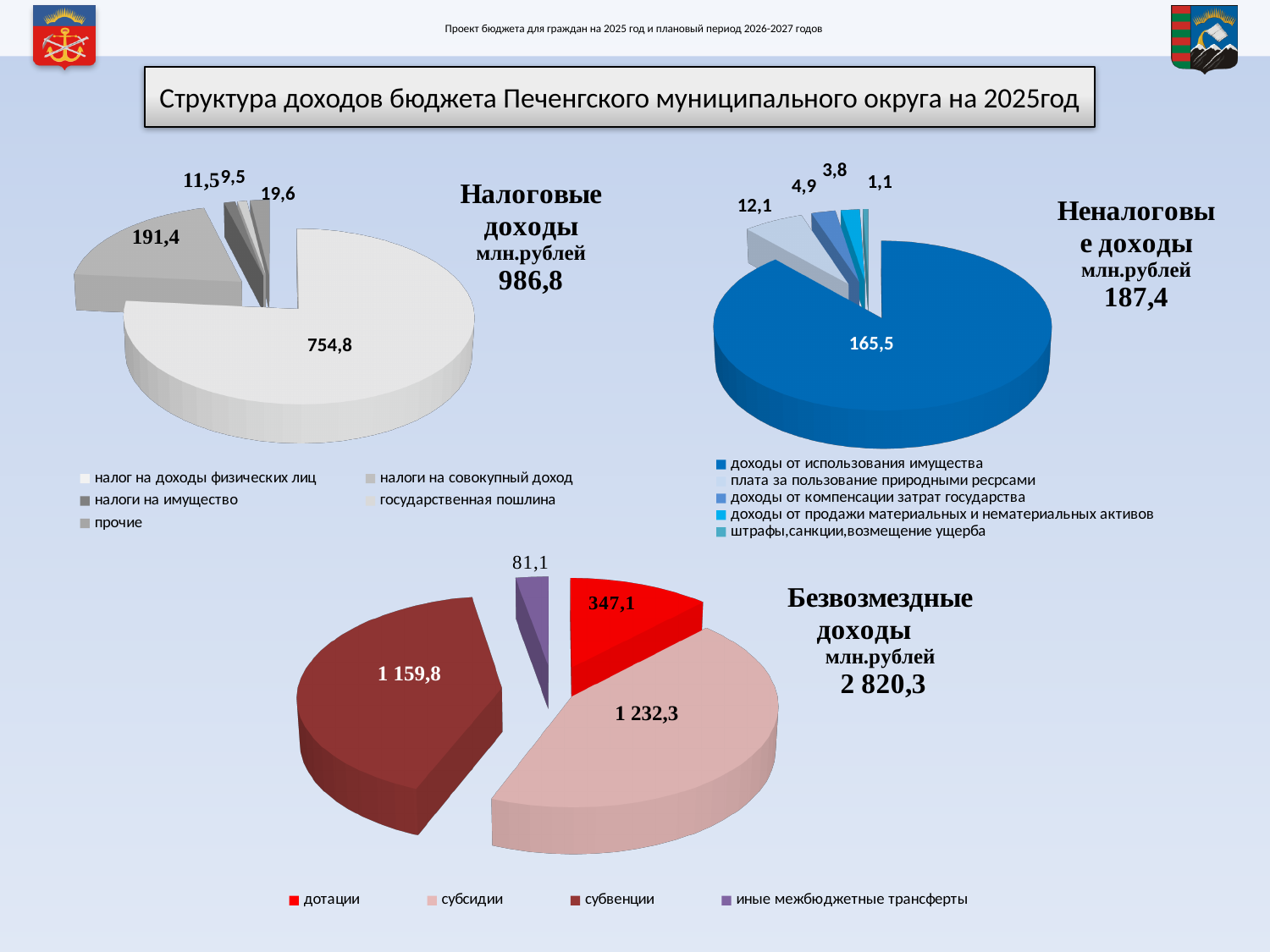
What kind of charts are shown on the slide? Pie charts In the 'Безвозмездные доходы' chart, what is the value for субсидии? 1 232,3 How many categories does the legend of the 'Неналоговые доходы' chart list? 5 In the 'Безвозмездные доходы' chart, which is larger: дотации or иные межбюджетные трансферты? дотации In the 'Безвозмездные доходы' chart, which category has the smallest slice? иные межбюджетные трансферты What is the total shown for 'Налоговые доходы' in млн.рублей? 986,8 In the 'Безвозмездные доходы' chart, which category has the largest slice? субсидии In the 'Налоговые доходы' chart, what is the value for налог на доходы физических лиц? 754,8 In the 'Неналоговые доходы' chart, what is the value for доходы от использования имущества? 165,5 In the 'Безвозмездные доходы' chart, what is the value for дотации? 347,1 In the 'Безвозмездные доходы' chart, what is the difference between субсидии and субвенции? 72,5 In the 'Налоговые доходы' chart, what is the value for налоги на совокупный доход? 191,4